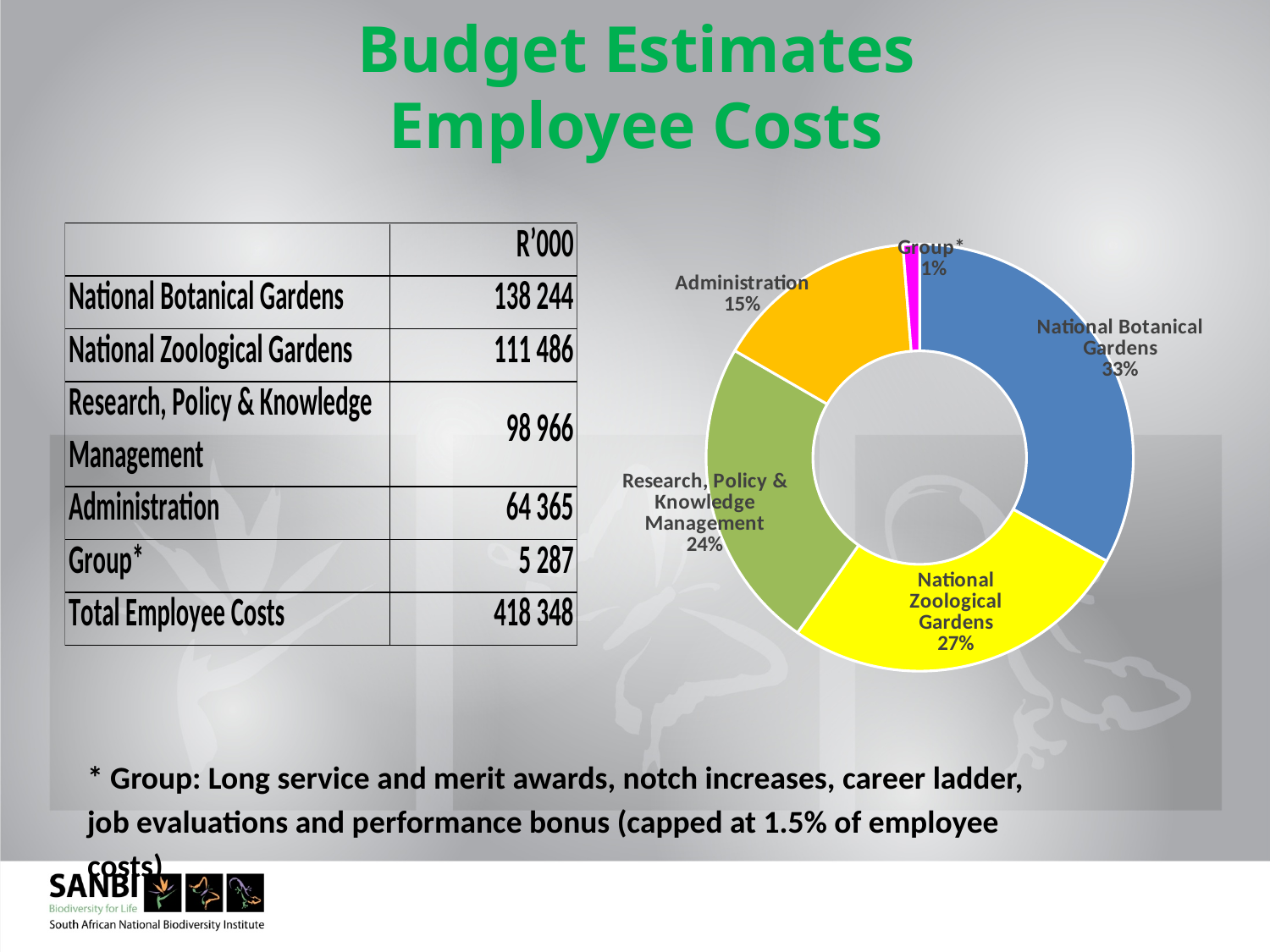
How many categories are shown in the chart? 5 What is the difference in percentage points between National Botanical Gardens and Administration in the chart? 18 What colour is the National Zoological Gardens slice in the chart? Yellow Which has the larger share in the chart, National Zoological Gardens or Research, Policy & Knowledge Management? National Zoological Gardens Which category has the largest share in the chart? National Botanical Gardens What share of employee costs does National Zoological Gardens account for in the chart? 27% What share of employee costs does National Botanical Gardens account for in the chart? 33% What percentage is shown for Group* in the chart? 1% Which category has the smallest share in the chart? Group* What percentage is shown for Administration in the chart? 15% What percentage is shown for Research, Policy & Knowledge Management in the chart? 24% What kind of chart is shown on the slide? Doughnut (pie) chart